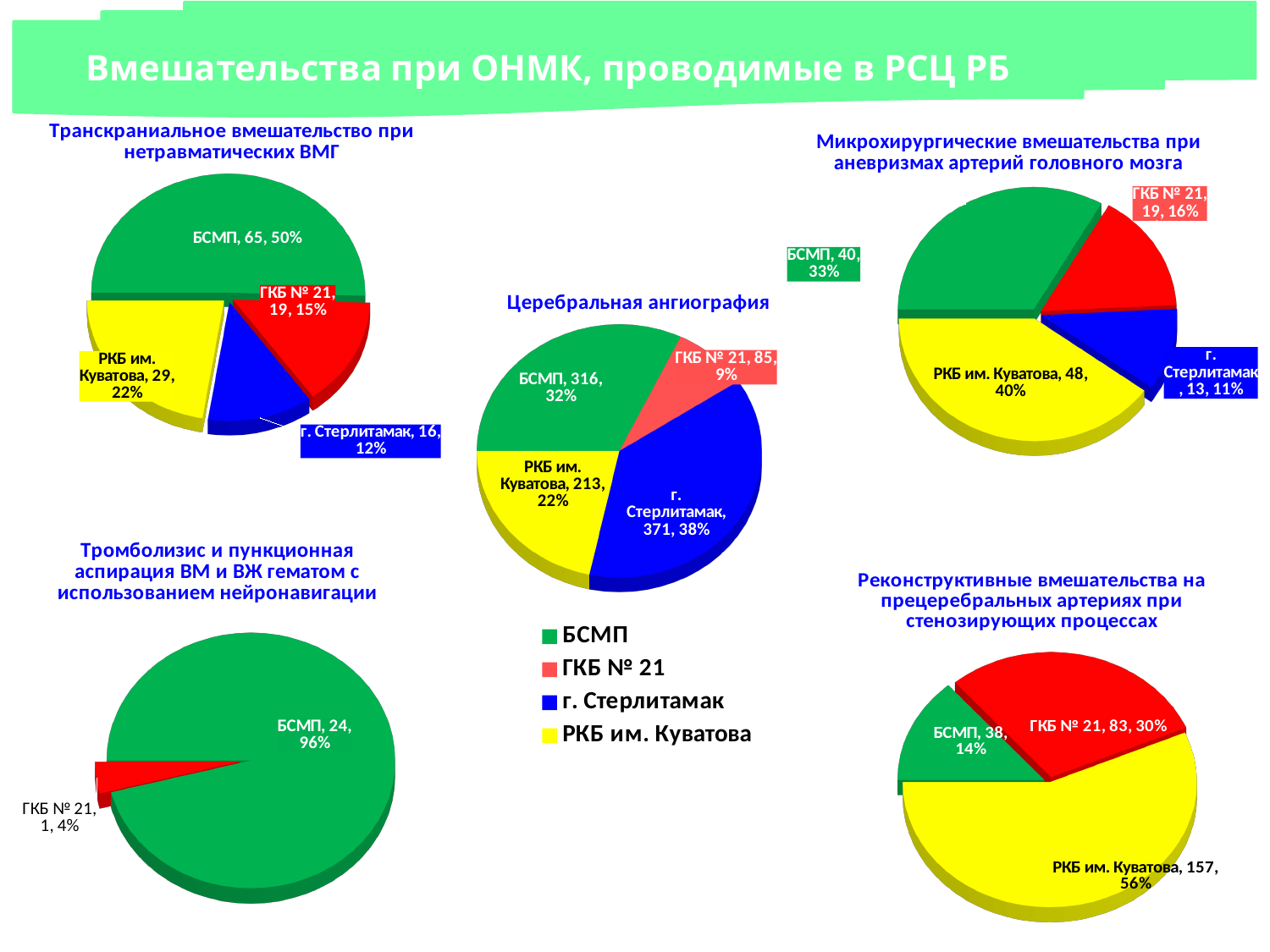
In the 'Церебральная ангиография' chart, which category has the largest slice? г. Стерлитамак In the 'Транскраниальное вмешательство при нетравматических ВМГ' chart, what is the difference between the values for БСМП and ГКБ № 21? 46 In the 'Микрохирургические вмешательства при аневризмах артерий головного мозга' chart, which category has the largest slice? РКБ им. Куватова In the 'Транскраниальное вмешательство при нетравматических ВМГ' chart, which category has the smallest slice? г. Стерлитамак In the 'Реконструктивные вмешательства на прецеребральных артериях при стенозирующих процессах' chart, what is the value for РКБ им. Куватова? 157 In the 'Реконструктивные вмешательства на прецеребральных артериях при стенозирующих процессах' chart, which is larger, the value for ГКБ № 21 or the value for БСМП? ГКБ № 21 In the 'Тромболизис и пункционная аспирация ВМ и ВЖ гематом с использованием нейронавигации' chart, how many categories are shown? 2 How many entries does the shared legend in the middle of the slide list? 4 In the 'Микрохирургические вмешательства при аневризмах артерий головного мозга' chart, what share of the pie does г. Стерлитамак have? 11% In the 'Церебральная ангиография' chart, what is the value for г. Стерлитамак? 371 In the 'Церебральная ангиография' chart, what share of the pie does ГКБ № 21 have? 9% In the 'Транскраниальное вмешательство при нетравматических ВМГ' chart, what is the value for РКБ им. Куватова? 29